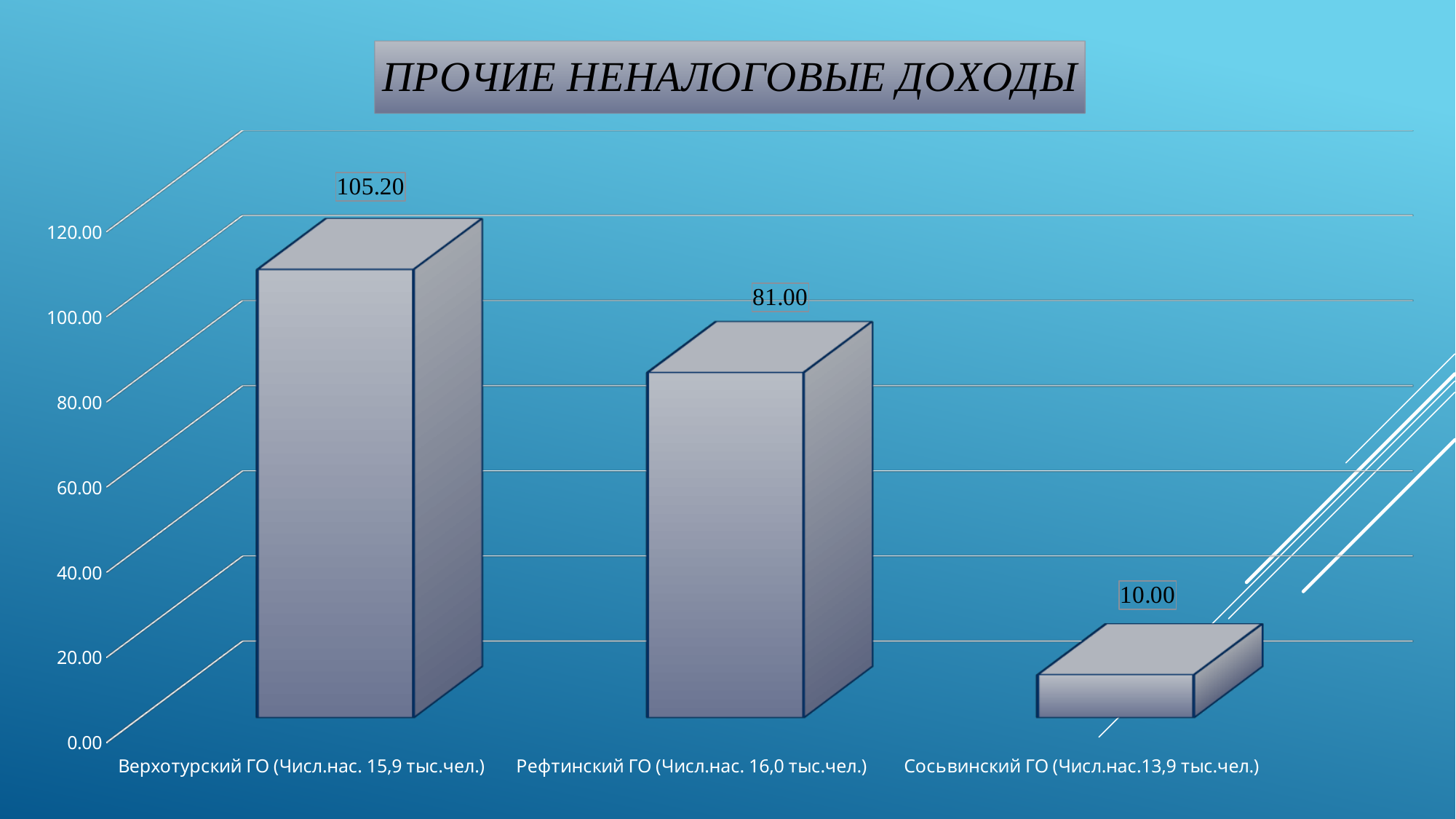
What kind of chart is shown on the slide? bar chart What is the difference between the values for Рефтинский ГО and Сосьвинский ГО? 71.00 Which category has the lowest value? Сосьвинский ГО Which is larger, the value for Рефтинский ГО or the value for Сосьвинский ГО? Рефтинский ГО Is the value for Рефтинский ГО greater or less than 100.00? less What is the value for Сосьвинский ГО? 10.00 What is the difference between the values for Верхотурский ГО and Рефтинский ГО? 24.20 What is the title of the chart? ПРОЧИЕ НЕНАЛОГОВЫЕ ДОХОДЫ What is the value for Рефтинский ГО? 81.00 How many categories are shown on the chart? 3 Which category has the highest value? Верхотурский ГО What is the value for Верхотурский ГО? 105.20